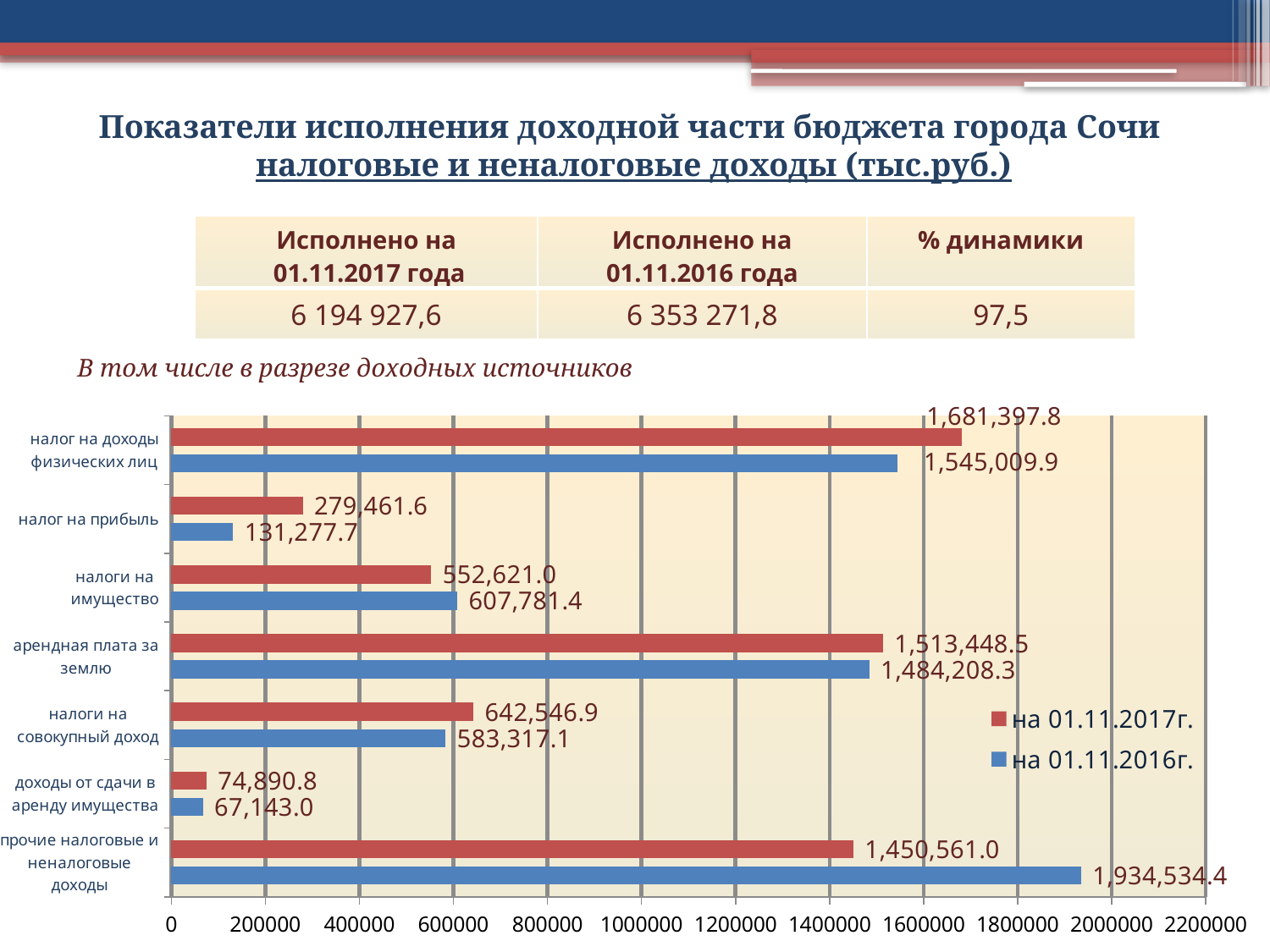
What is the value for налоги на имущество on 01.11.2017? 552,621.0 How many income source categories are shown in the chart? 7 What is the difference between the 01.11.2017 and 01.11.2016 values for налог на прибыль? 148,183.9 How many series does the chart legend list? 2 Which colour represents the series на 01.11.2016г. in the chart? blue For прочие налоговые и неналоговые доходы, which is larger: the value on 01.11.2017 or on 01.11.2016? 01.11.2016 What is the value for налог на доходы физических лиц on 01.11.2017? 1,681,397.8 Is the value for налоги на совокупный доход on 01.11.2017 greater or less than 600000? greater What type of chart is shown on the slide? bar chart Which category has the lowest value for the series на 01.11.2016г.? доходы от сдачи в аренду имущества What is the value for прочие налоговые и неналоговые доходы on 01.11.2016? 1,934,534.4 Which category has the highest value for the series на 01.11.2017г.? налог на доходы физических лиц